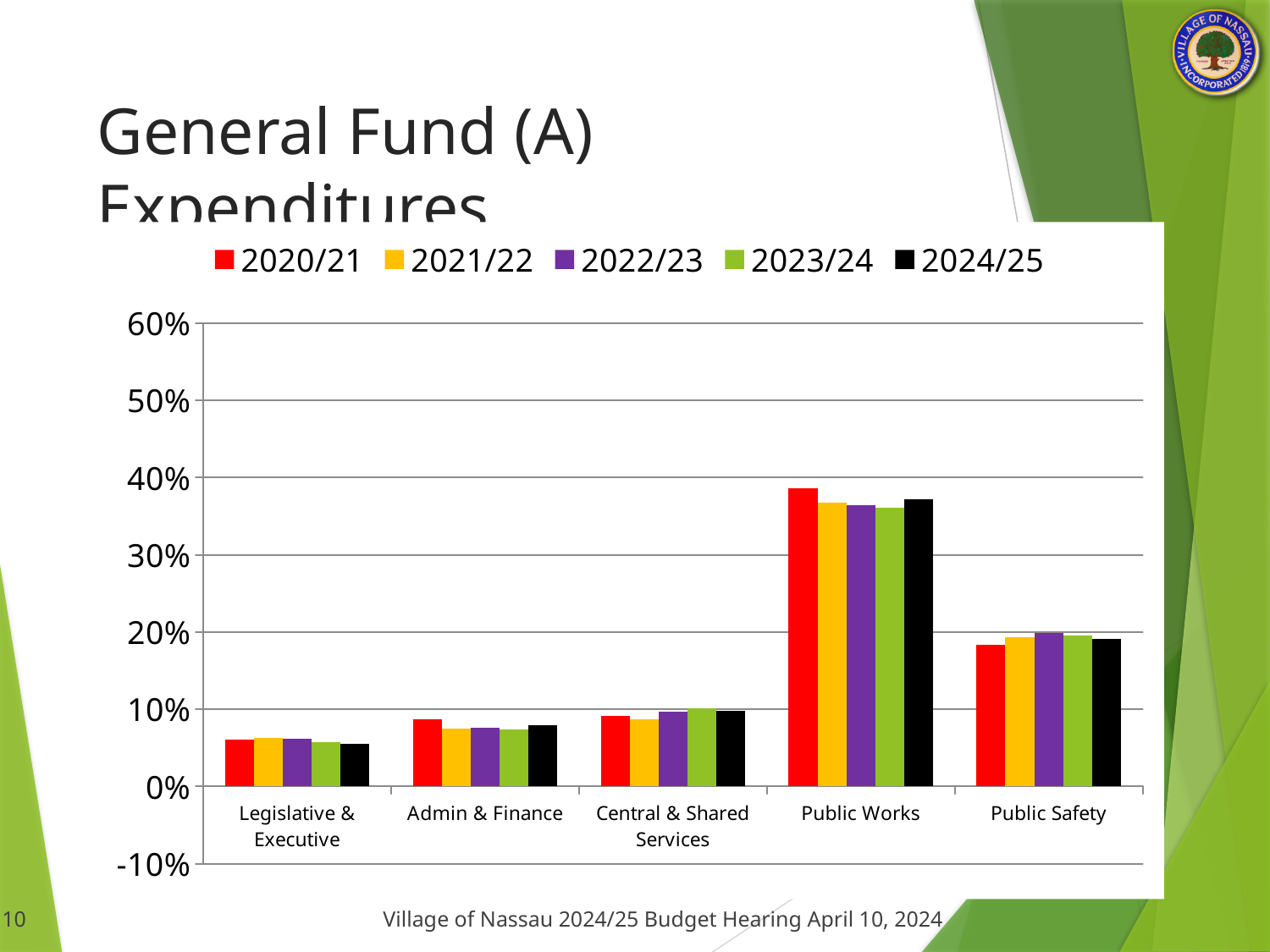
How many series does the legend list? 5 Is the value for Public Safety in 2020/21 greater or less than 10%? greater Is the value for Legislative & Executive in 2020/21 greater or less than 10%? less For 2024/25, which is larger: Public Works or Public Safety? Public Works Which category has the lowest values across all years? Legislative & Executive Which colour represents the 2024/25 series in the legend? black How many categories are shown on the x axis? 5 For 2020/21, which is larger: Admin & Finance or Legislative & Executive? Admin & Finance Which category has the highest values across all years? Public Works Is the value for Public Works in 2020/21 greater or less than 30%? greater What kind of chart is shown on the slide? bar chart